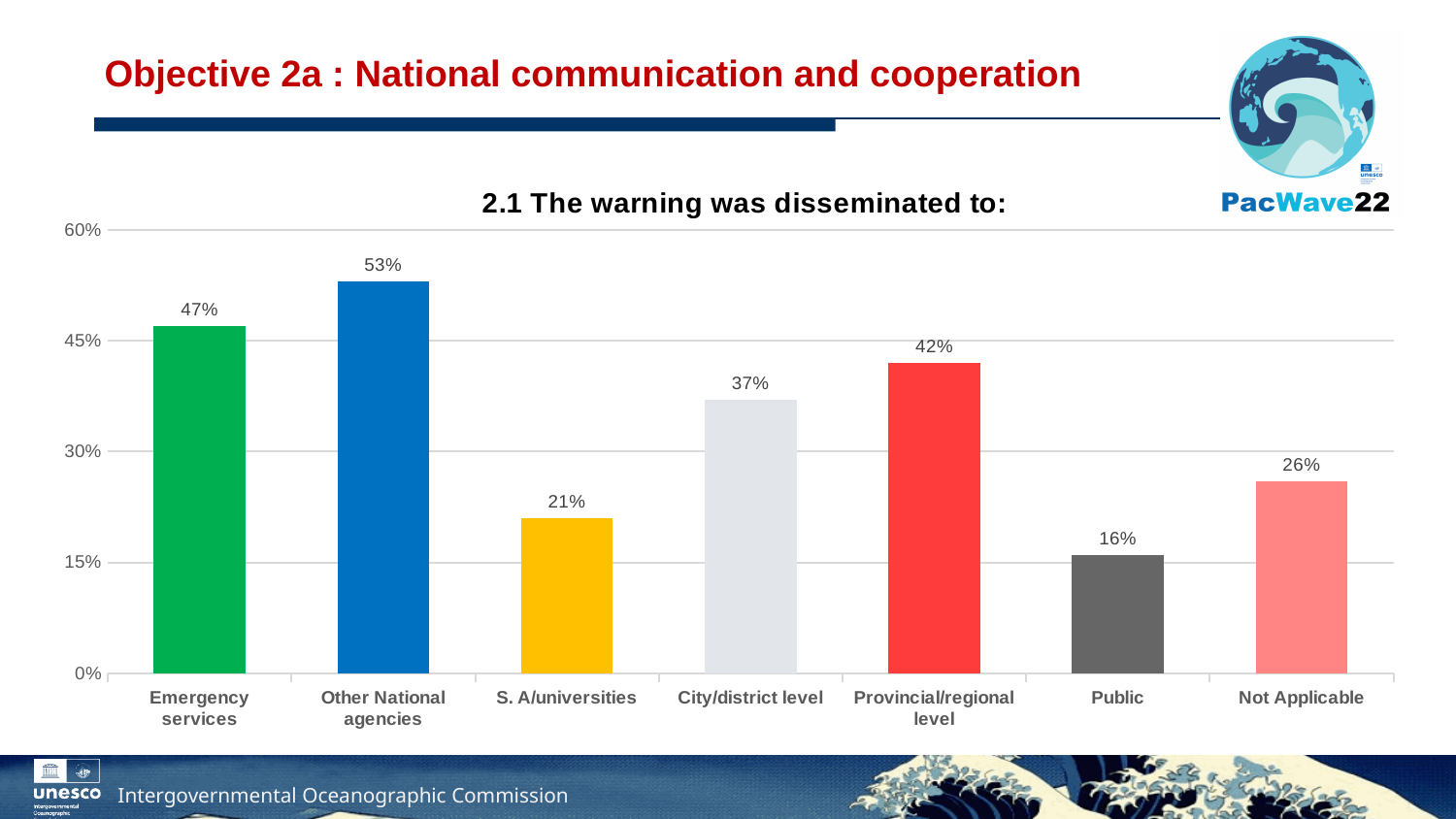
What percentage of warnings were disseminated to Emergency services? 47% What is the difference between the values for Provincial/regional level and City/district level? 5% Which is larger, the value for S. A/universities or the value for Not Applicable? Not Applicable What is the value for Other National agencies? 53% What is the value for Public? 16% What is the difference between the values for Other National agencies and Emergency services? 6% What type of chart is shown on the slide? bar chart How many categories are shown on the x axis? 7 Which category has the lowest value? Public What is the value for Not Applicable? 26% Which category has the highest value? Other National agencies Is the value for City/district level greater or less than 30%? greater